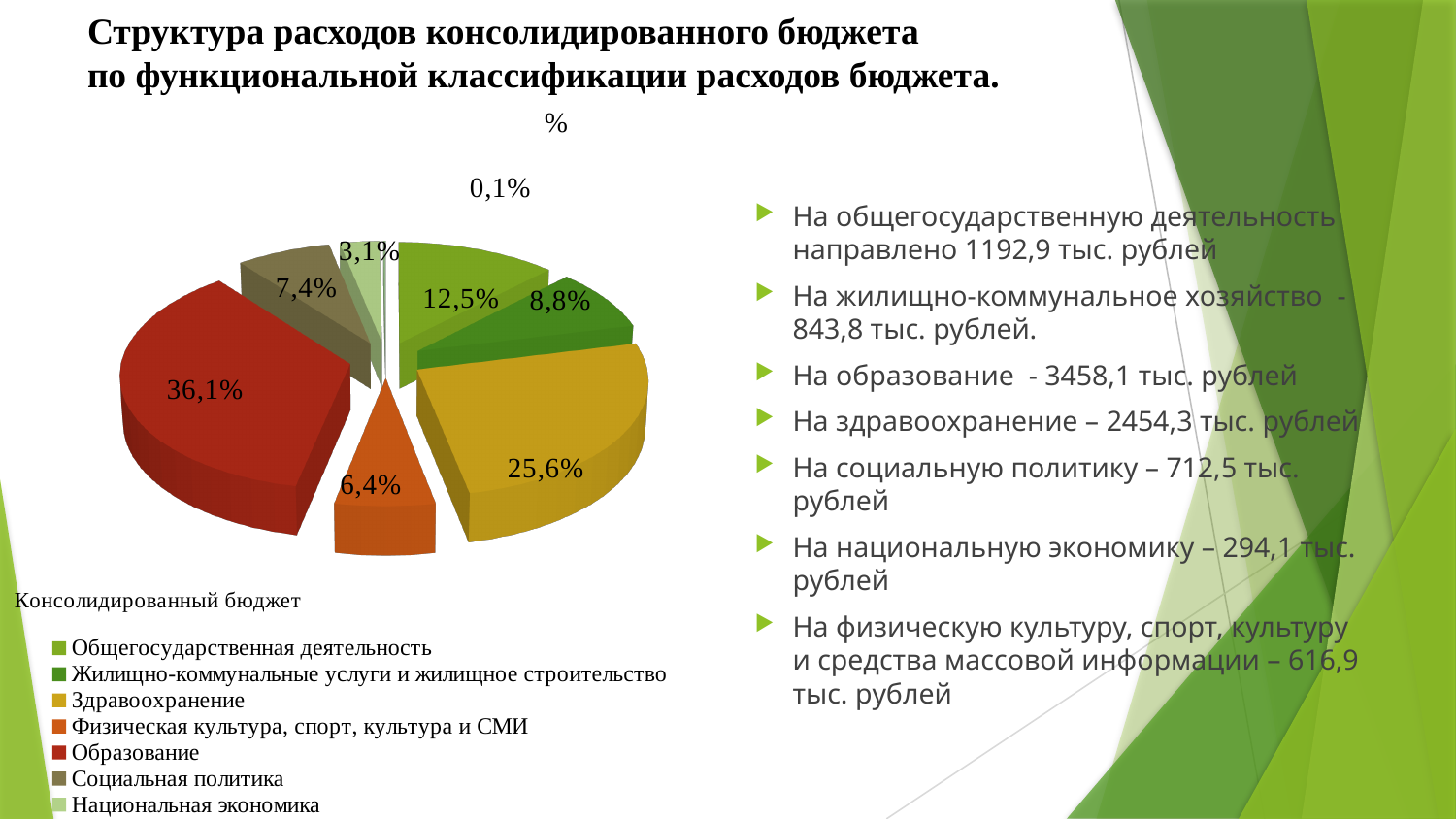
What is the share for Национальная экономика in the pie chart? 3,1% What is the share for Образование in the pie chart? 36,1% What is the share for Социальная политика in the pie chart? 7,4% What is the difference in percentage points between Образование and Здравоохранение in the pie chart? 10,5 What is the share for Физическая культура, спорт, культура и СМИ in the pie chart? 6,4% What type of chart is shown on the slide? pie chart Which is larger in the pie chart: Здравоохранение or Общегосударственная деятельность? Здравоохранение What is the share for Здравоохранение in the pie chart? 25,6% What is the share for Общегосударственная деятельность in the pie chart? 12,5% What is the share for Жилищно-коммунальные услуги и жилищное строительство in the pie chart? 8,8% How many categories does the legend of the pie chart list? 7 Which legend category has the largest slice in the pie chart? Образование